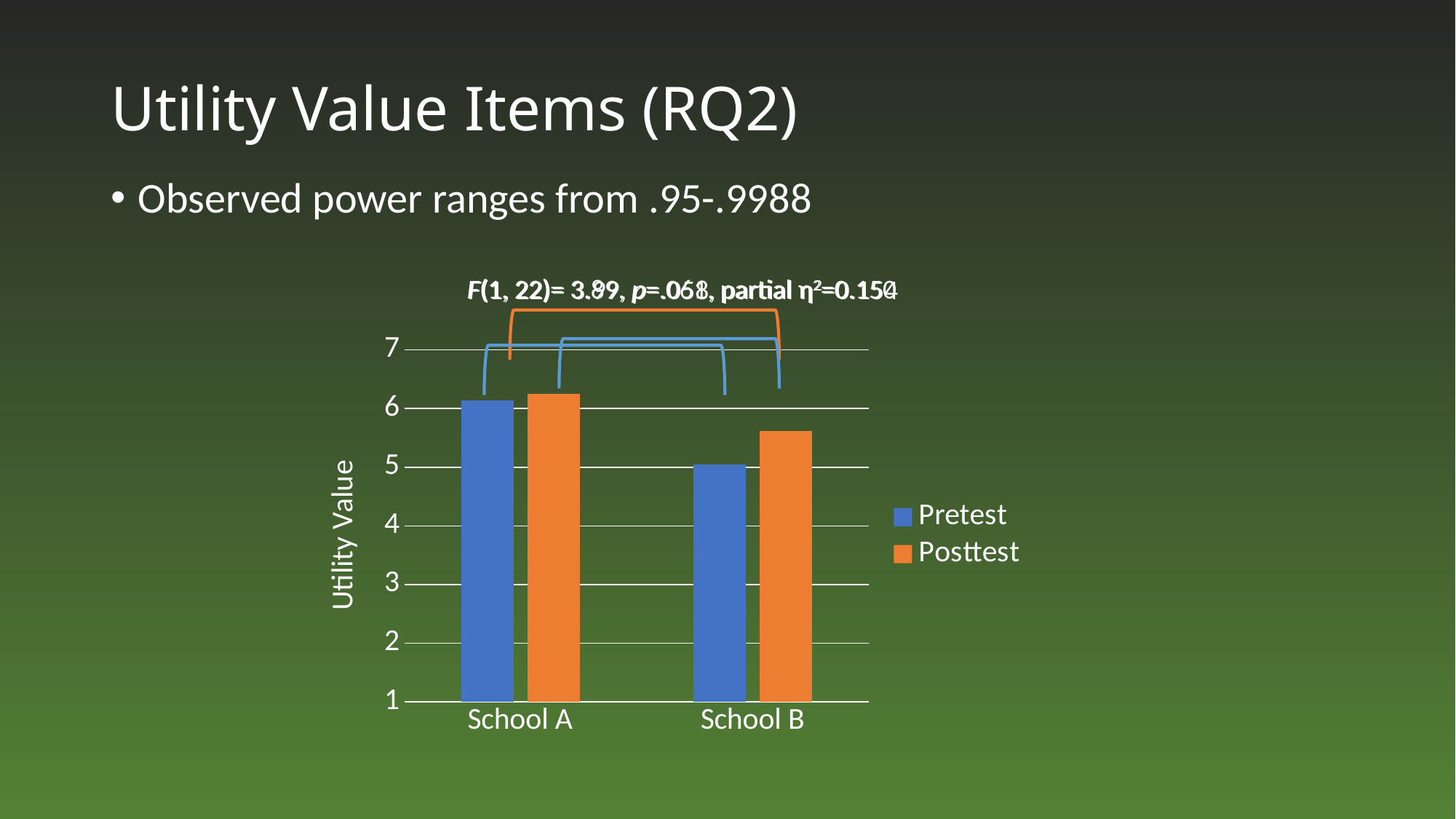
Is the Pretest value for School B greater or less than 6? less Which school has the higher Posttest value, School A or School B? School A Is the Posttest value for School B greater or less than 6? less Which bar in the chart is the lowest? School B Pretest How many series does the chart legend list? 2 What is the title of the vertical axis of the chart? Utility Value Which school has the higher Pretest value, School A or School B? School A How many categories are shown on the x axis of the chart? 2 Is the Posttest value for School A greater or less than 7? less What kind of chart is shown on the slide? bar chart Which series is shown in orange in the chart? Posttest